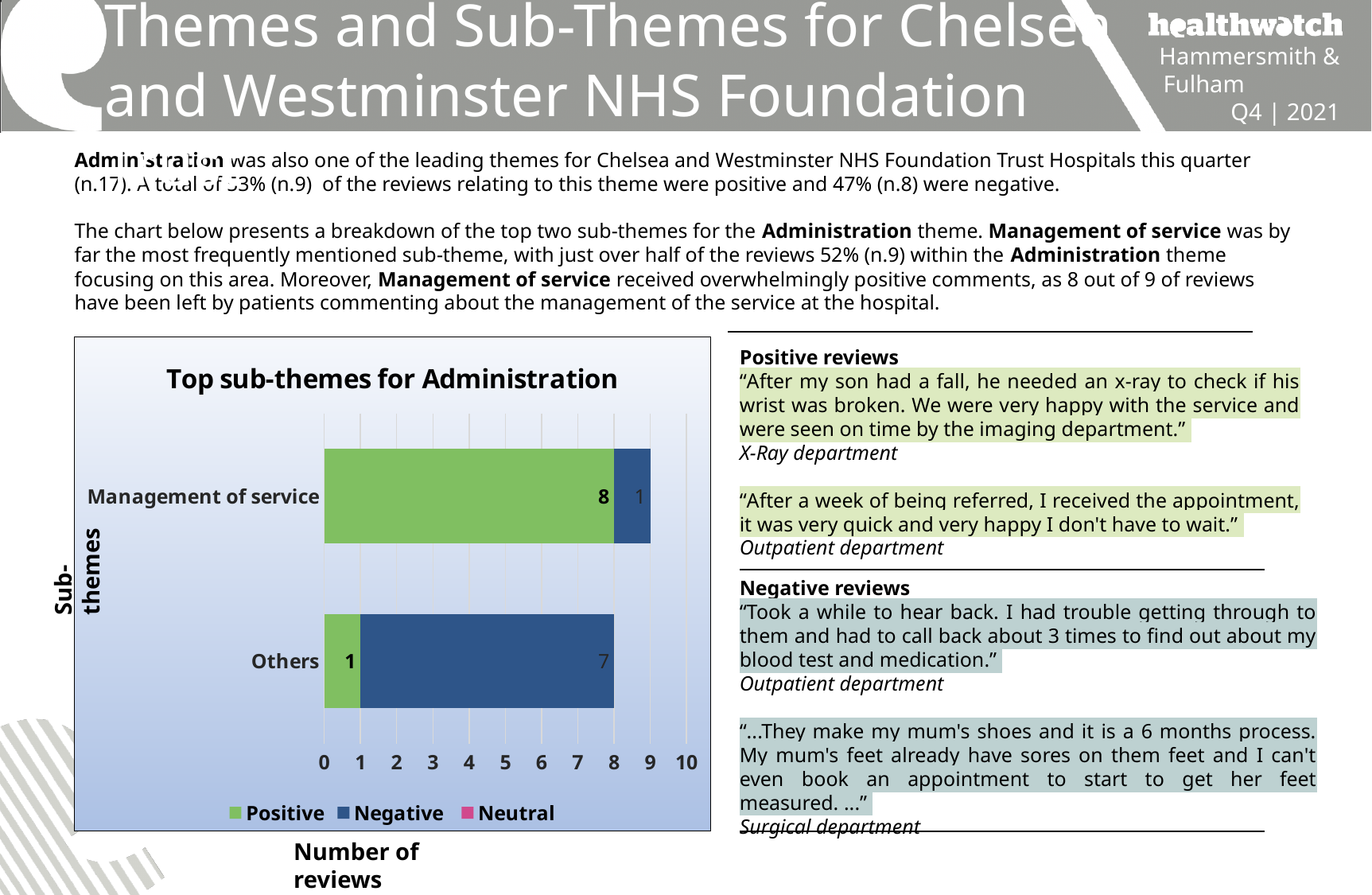
How many Negative reviews are shown for Others? 7 What is the total number of reviews in the Others bar? 8 What is the title of the chart? Top sub-themes for Administration What is the total number of reviews in the Management of service bar? 9 How many Negative reviews are shown for Management of service? 1 How many Positive reviews are shown for Others? 1 How many sub-theme categories are plotted in the chart? 2 How many series does the chart legend list? 3 What is the difference between the Negative reviews for Others and for Management of service? 6 How many Positive reviews are shown for Management of service? 8 What kind of chart is shown on the slide? bar chart Which sub-theme has the higher number of Positive reviews, Management of service or Others? Management of service